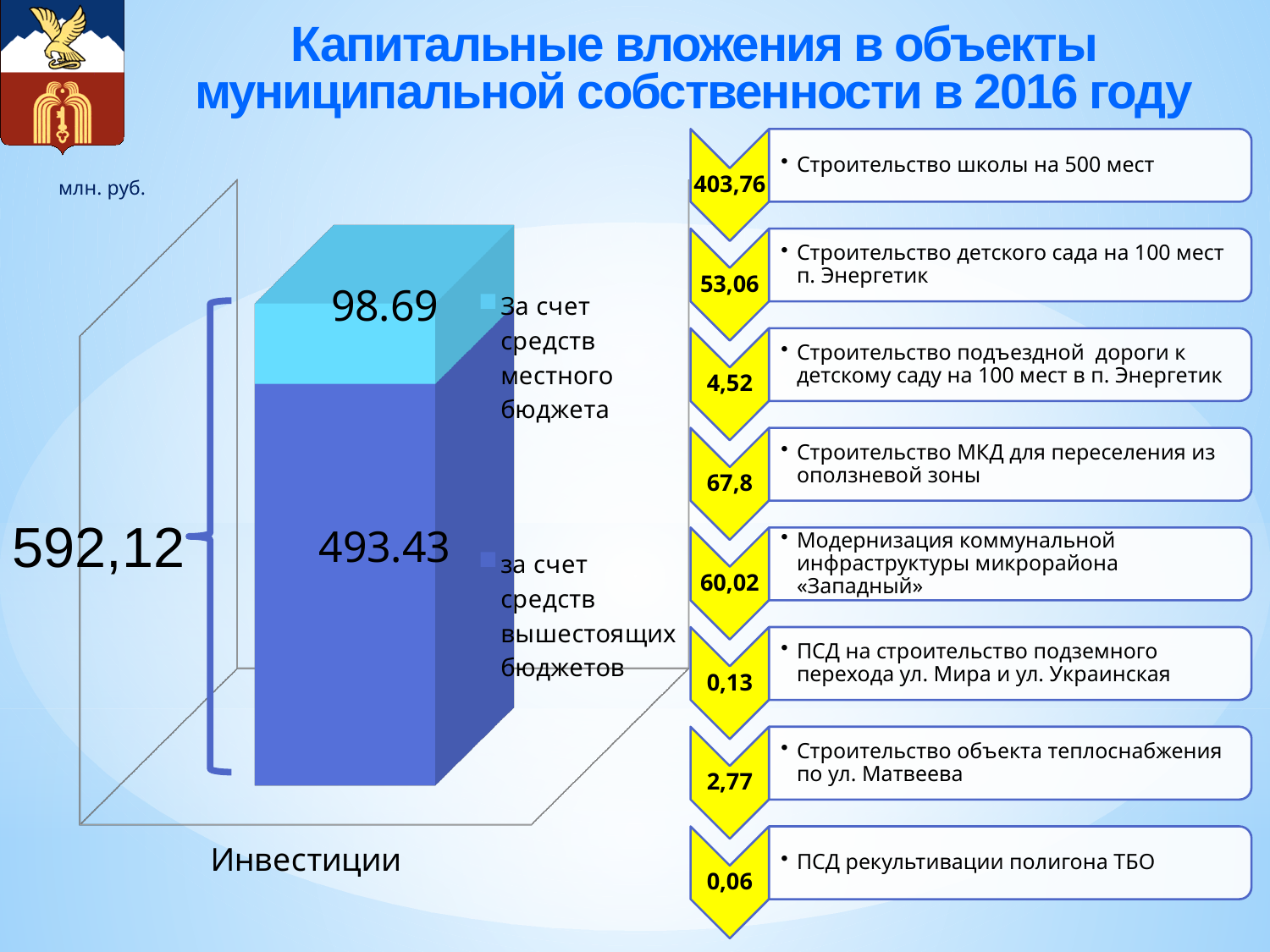
Which series has the smallest value in the bar chart? За счет средств местного бюджета What is the value for the series "За счет средств местного бюджета" in the bar chart? 98.69 What type of chart is shown on the slide? bar chart What is the total of the stacked bar "Инвестиции" as shown on the slide? 592,12 What is the category label on the x axis of the bar chart? Инвестиции What is the difference between the values for "за счет средств вышестоящих бюджетов" and "За счет средств местного бюджета" in the bar chart? 394.74 Which series has the larger value in the bar chart: "За счет средств местного бюджета" or "за счет средств вышестоящих бюджетов"? за счет средств вышестоящих бюджетов What unit is indicated for the values in the bar chart? млн. руб. What is the value for the series "за счет средств вышестоящих бюджетов" in the bar chart? 493.43 How many categories are shown on the x axis of the bar chart? 1 How many series does the legend of the bar chart list? 2